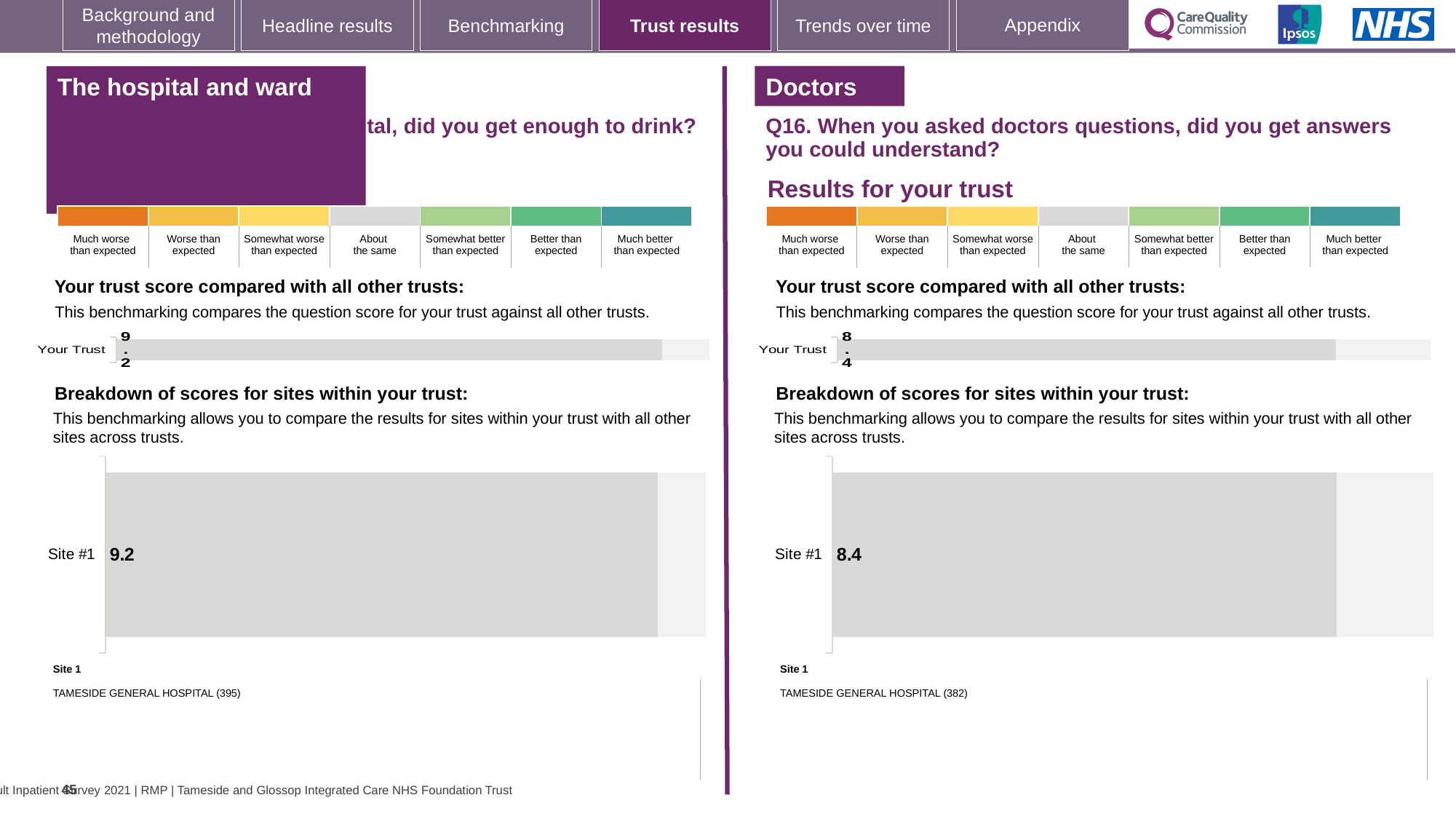
In the 'Your trust score compared with all other trusts' chart on the right (Doctors, Q16), what is the value for Your Trust? 8.4 Which Your Trust score is larger: the one in the left chart (The hospital and ward) or the one in the right chart (Doctors, Q16)? The left chart (9.2) In the 'Breakdown of scores for sites within your trust' chart on the right (Doctors, Q16), what is the value for Site #1? 8.4 How many sites are shown in the 'Breakdown of scores for sites within your trust' chart on the left? 1 How many sites are shown in the 'Breakdown of scores for sites within your trust' chart on the right (Doctors, Q16)? 1 In the 'Breakdown of scores for sites within your trust' chart on the left (The hospital and ward), what is the value for Site #1? 9.2 What is the difference between the Your Trust score in the left chart (9.2) and the Your Trust score in the right chart (8.4)? 0.8 How many categories does the colour key above the charts show, from 'Much worse than expected' to 'Much better than expected'? 7 In the 'Your trust score compared with all other trusts' chart on the left (The hospital and ward), what is the value for Your Trust? 9.2 Which hospital is listed as Site 1 beneath the site breakdown chart on the left? TAMESIDE GENERAL HOSPITAL (395) In the site breakdown chart on the right (Doctors, Q16), is the value for Site #1 greater or less than 9? less What kind of chart is used for the 'Your trust score compared with all other trusts' on the left? Bar chart